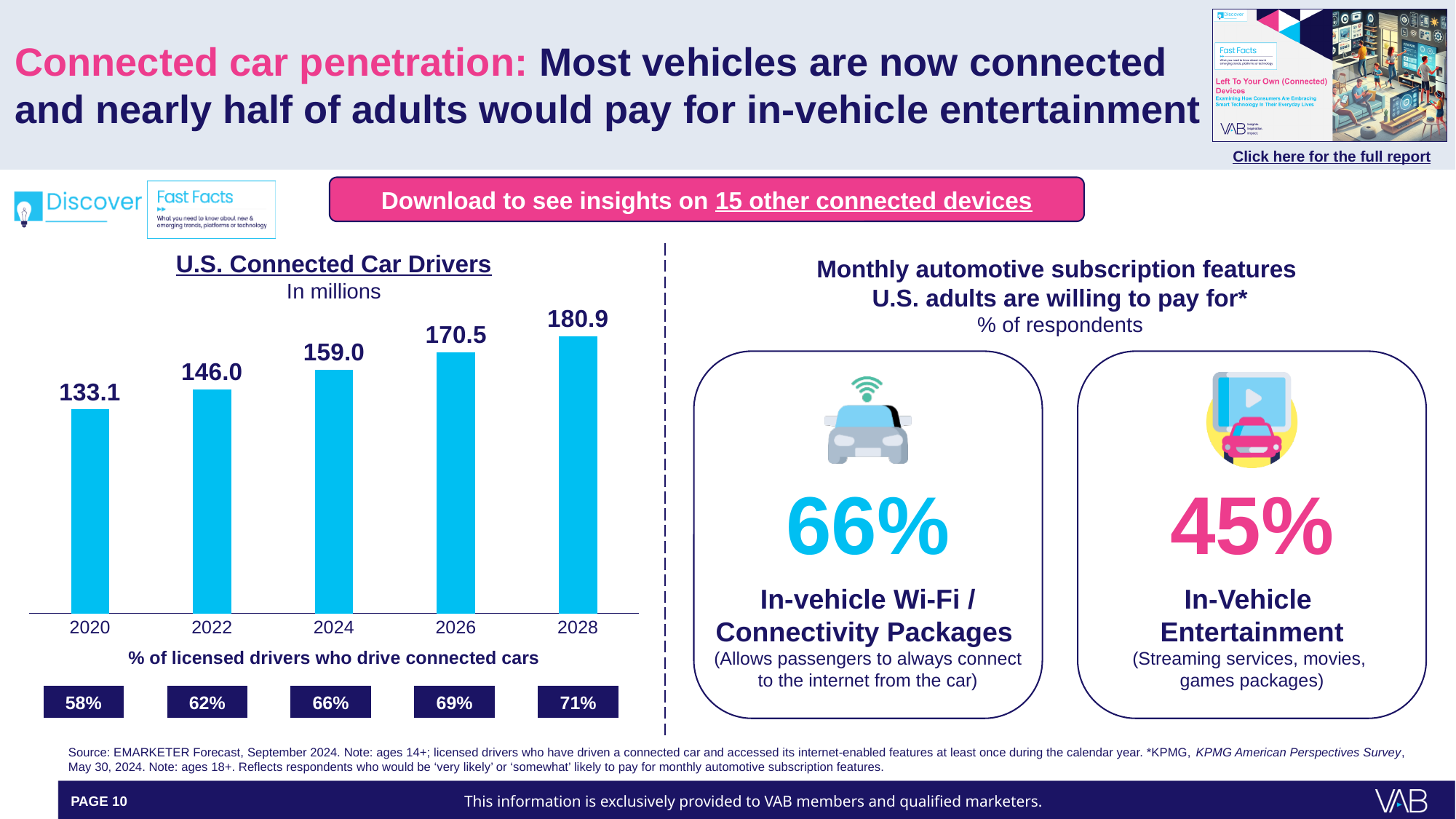
In the U.S. Connected Car Drivers chart, what is the difference between the 2026 and 2022 values? 24.5 In the U.S. Connected Car Drivers chart, what is the value for 2020? 133.1 How many bars are shown in the U.S. Connected Car Drivers chart? 5 In the U.S. Connected Car Drivers chart, what is the difference between the 2028 and 2020 values? 47.8 What unit is stated under the title of the U.S. Connected Car Drivers chart? In millions In the U.S. Connected Car Drivers chart, do the values rise or fall from 2020 to 2028? Rise In the U.S. Connected Car Drivers chart, what is the value for 2028? 180.9 In the U.S. Connected Car Drivers chart, what is the value for 2024? 159.0 In the U.S. Connected Car Drivers chart, which year has the highest value? 2028 In the U.S. Connected Car Drivers chart, which is larger, the value for 2022 or the value for 2026? 2026 In the U.S. Connected Car Drivers chart, which year has the lowest value? 2020 What kind of chart is the U.S. Connected Car Drivers chart? Bar chart